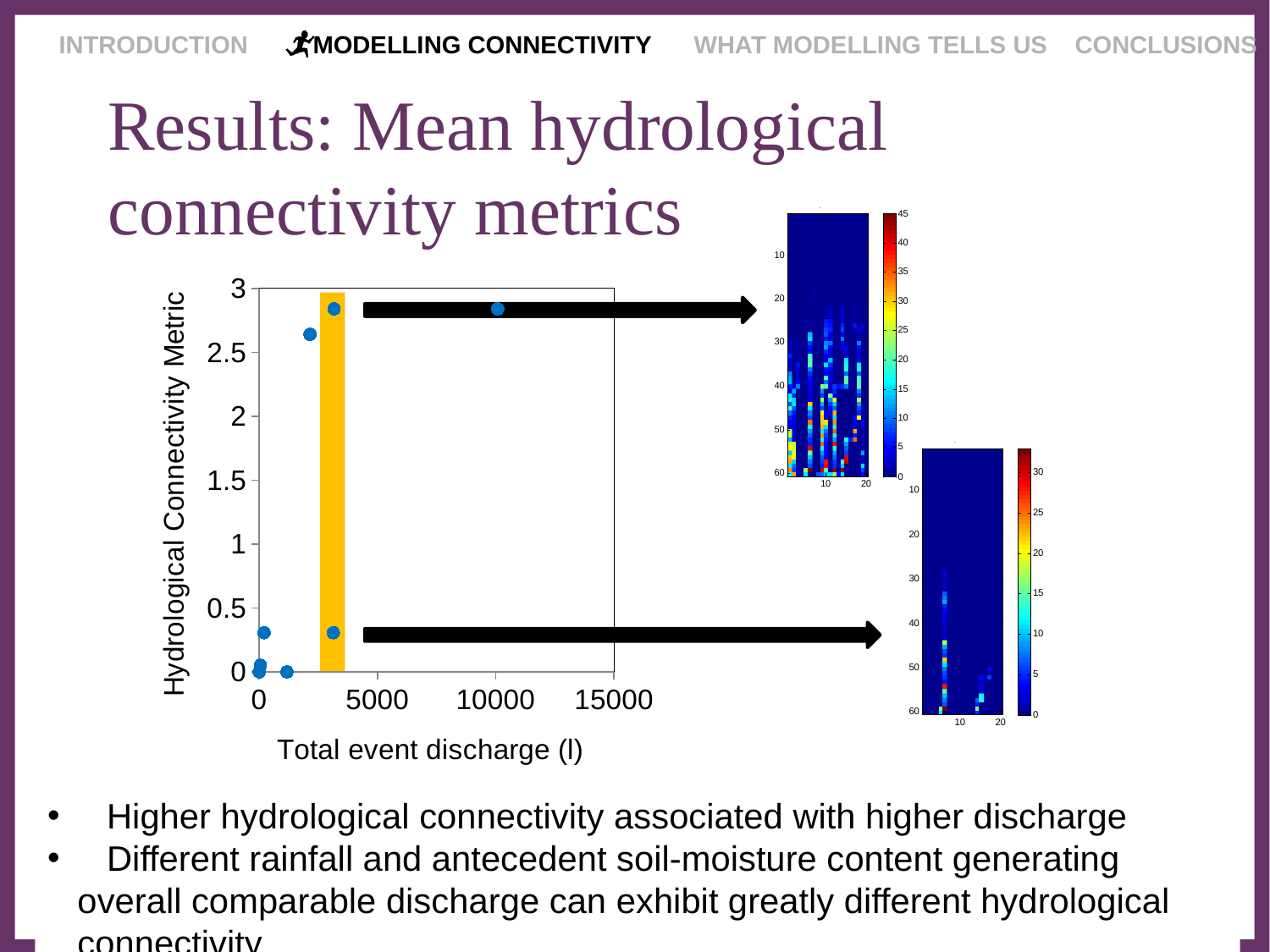
In the scatter plot, is the Hydrological Connectivity Metric of the point with the largest total event discharge greater or less than 2.5? greater In the scatter plot, do the points with the highest total event discharge have higher or lower Hydrological Connectivity Metric values than the points near zero discharge? higher What is the label of the x axis of the scatter plot? Total event discharge (l) What kind of chart is the plot of Hydrological Connectivity Metric against Total event discharge? scatter plot What is the highest tick value shown on the x axis of the scatter plot? 15000 According to the scatter plot, does hydrological connectivity generally rise or fall as total event discharge increases? rise What is the maximum value on the colour bar of the lower heatmap on the right? 30 What is the highest tick value shown on the y axis of the scatter plot? 3 What is the maximum value on the colour bar of the upper heatmap on the right? 45 In the scatter plot, is the Hydrological Connectivity Metric of the lower point highlighted by the yellow band greater or less than 1? less In the scatter plot, is the total event discharge of the rightmost point greater or less than 5000? greater What is the label of the y axis of the scatter plot? Hydrological Connectivity Metric